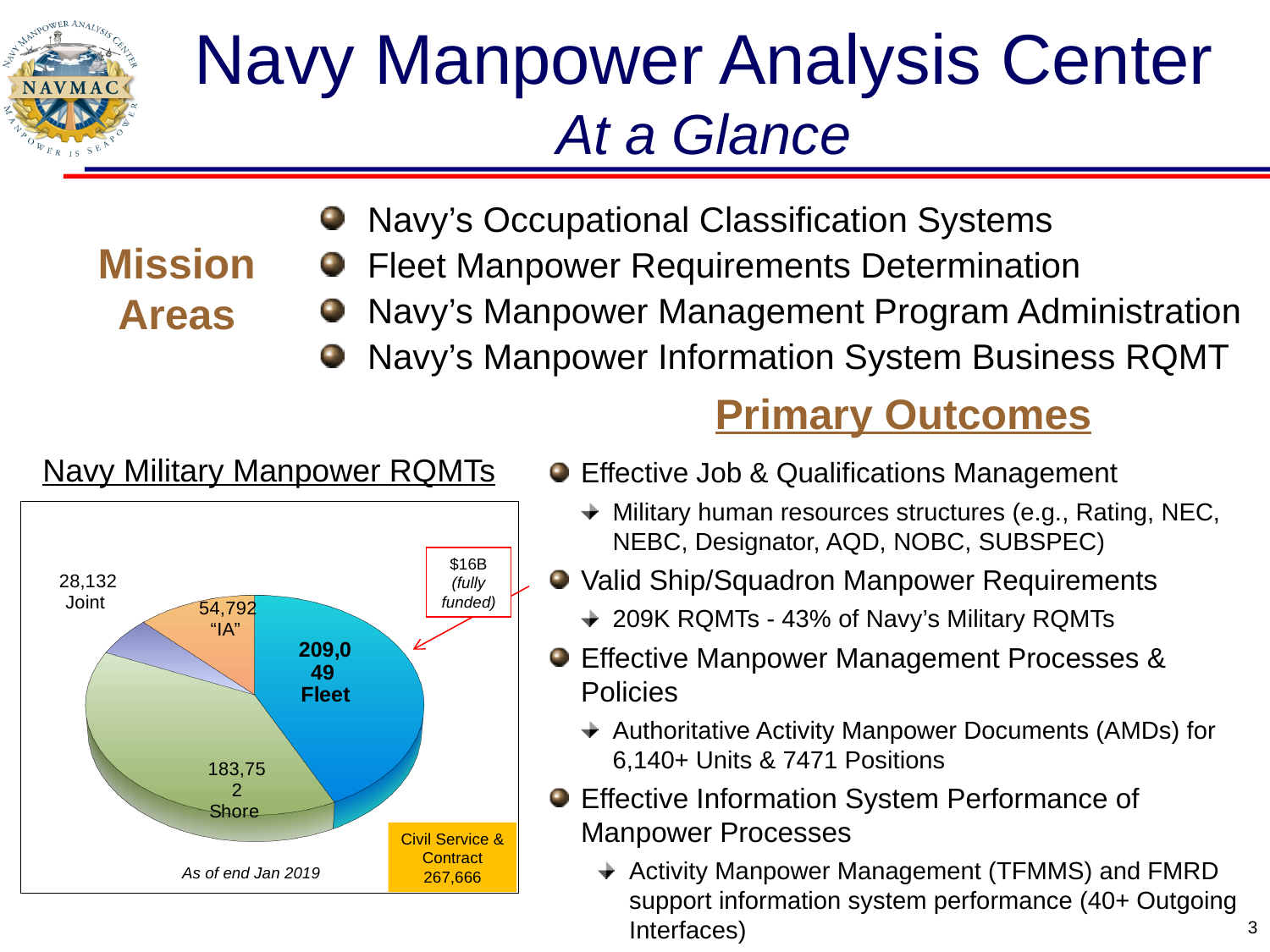
What is the value of the Fleet slice in the pie chart? 209,049 What date note appears at the bottom of the pie chart? As of end Jan 2019 What is the difference between the Fleet and Shore values in the pie chart? 25,297 What is the value of the Joint slice in the pie chart? 28,132 What is the value of the "IA" slice in the pie chart? 54,792 What is the difference between the "IA" and Joint values in the pie chart? 26,660 Which slice of the pie chart is the smallest? Joint What type of chart is shown under "Navy Military Manpower RQMTs"? Pie chart Which slice of the pie chart is the largest? Fleet How many slices does the pie chart have? 4 What is the value of the Shore slice in the pie chart? 183,752 Which is larger in the pie chart, Shore or "IA"? Shore